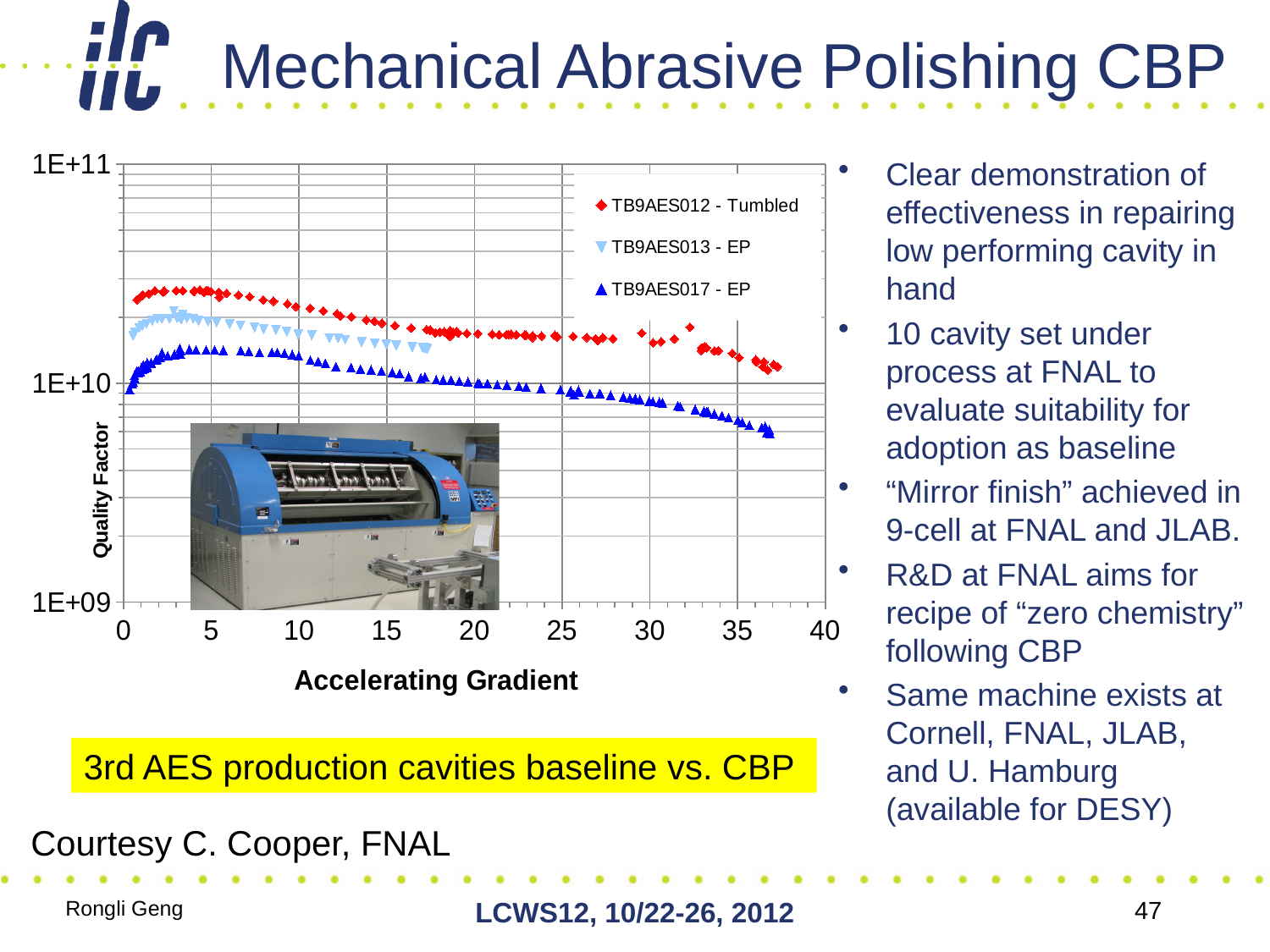
What is the title of the chart's y axis? Quality Factor What kind of chart is shown on the slide? Scatter chart Is the quality factor for TB9AES012 - Tumbled at an accelerating gradient of 5 greater or less than 1E+10? greater Which series stops at the lowest accelerating gradient? TB9AES013 - EP Which series has the highest quality factor at an accelerating gradient of 10? TB9AES012 - Tumbled Which series reaches the highest accelerating gradient? TB9AES012 - Tumbled What is the title of the chart's x axis? Accelerating Gradient Which series in the legend is marked with red diamonds? TB9AES012 - Tumbled Does the quality factor for TB9AES017 - EP rise or fall as the accelerating gradient increases? Fall How many series does the chart legend list? 3 Which series has the lowest quality factor at an accelerating gradient of 5? TB9AES017 - EP Is the quality factor for TB9AES017 - EP at an accelerating gradient of 35 greater or less than 1E+10? less